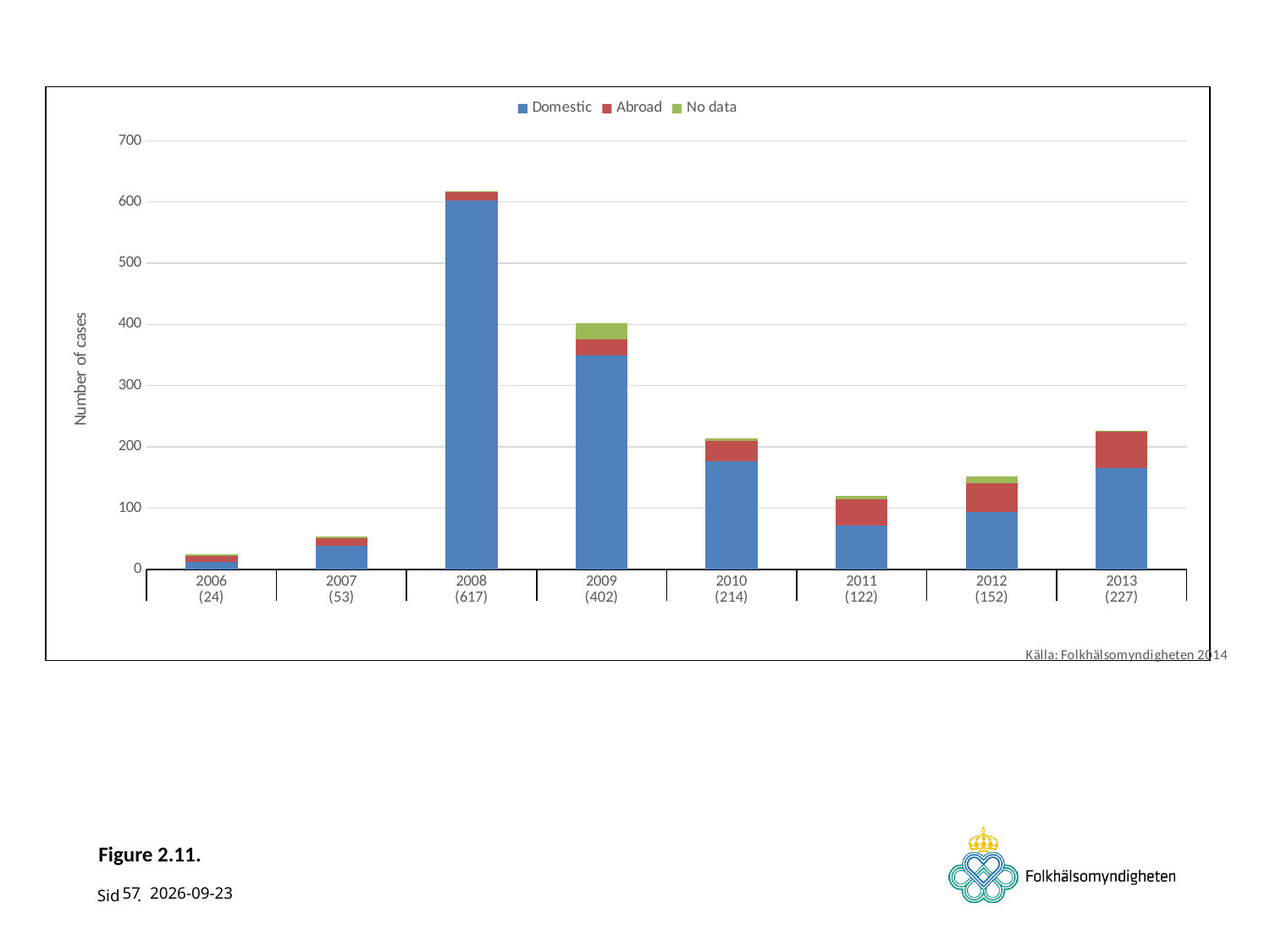
How many years are shown on the x axis? 8 Which year has the highest total number of cases? 2008 What kind of chart is shown on the slide? Stacked bar chart What is the difference between the total cases in 2008 and 2009? 215 What is the label of the y axis? Number of cases Which year has the lowest total number of cases? 2006 Which year has a larger total number of cases, 2012 or 2013? 2013 Is the Domestic value for 2008 greater or less than 500? greater What is the total number of cases shown for 2008? 617 Is the Domestic value for 2011 greater or less than 100? less What is the total number of cases shown for 2011? 122 How many series does the legend list? 3